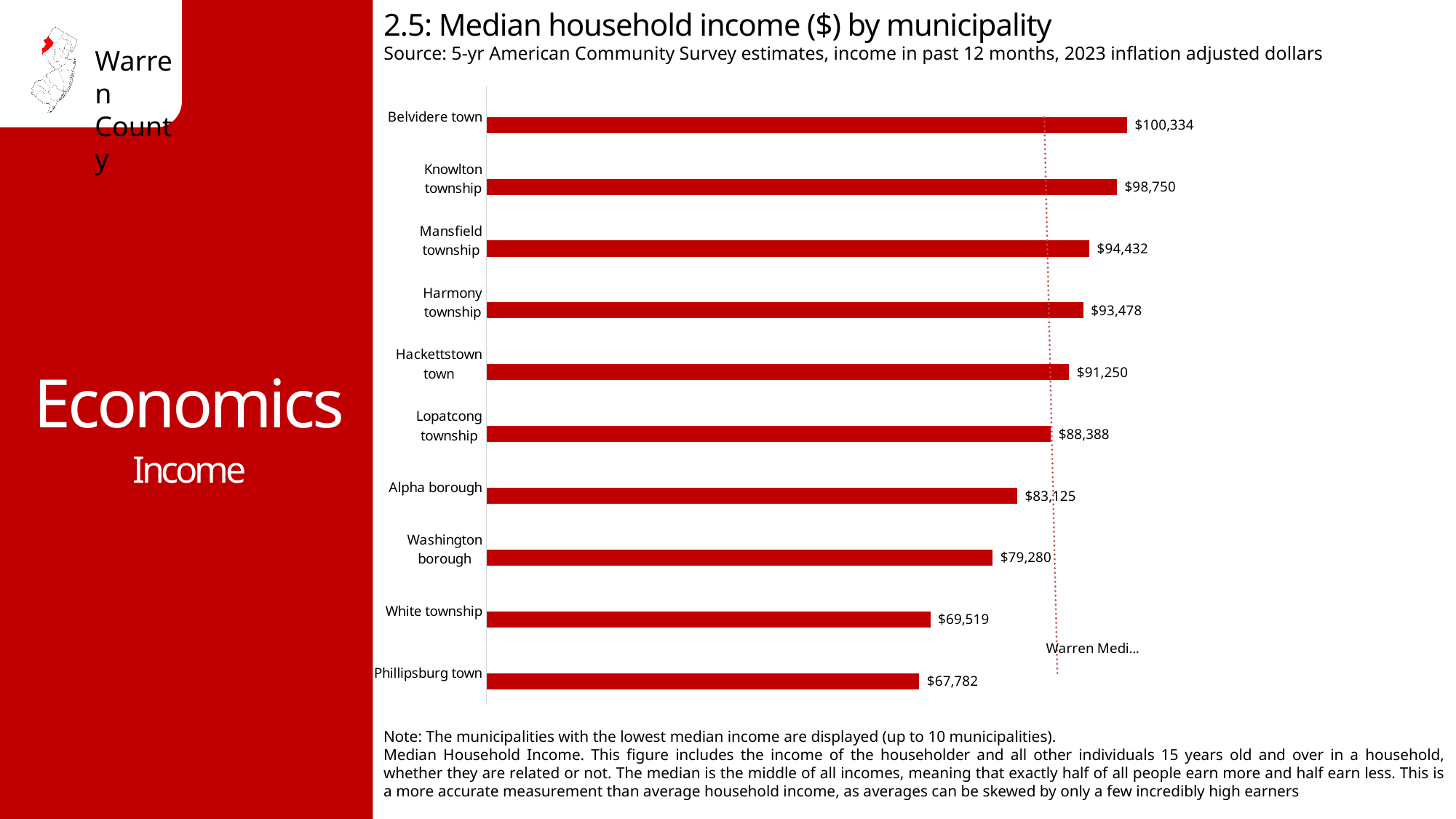
What is the difference in median household income between Knowlton township and Mansfield township? $4,318 Which has a higher median household income, Alpha borough or White township? Alpha borough What is the median household income for Belvidere town? $100,334 What is the difference in median household income between Belvidere town and Phillipsburg town? $32,552 What is the title of the chart? 2.5: Median household income ($) by municipality What is the median household income for Washington borough? $79,280 Which municipality has the highest median household income shown on the chart? Belvidere town How many municipalities are shown on the chart? 10 What type of chart is used on this slide? Bar chart Which municipality has the lowest median household income shown on the chart? Phillipsburg town What is the median household income for Phillipsburg town? $67,782 What is the median household income for Lopatcong township? $88,388